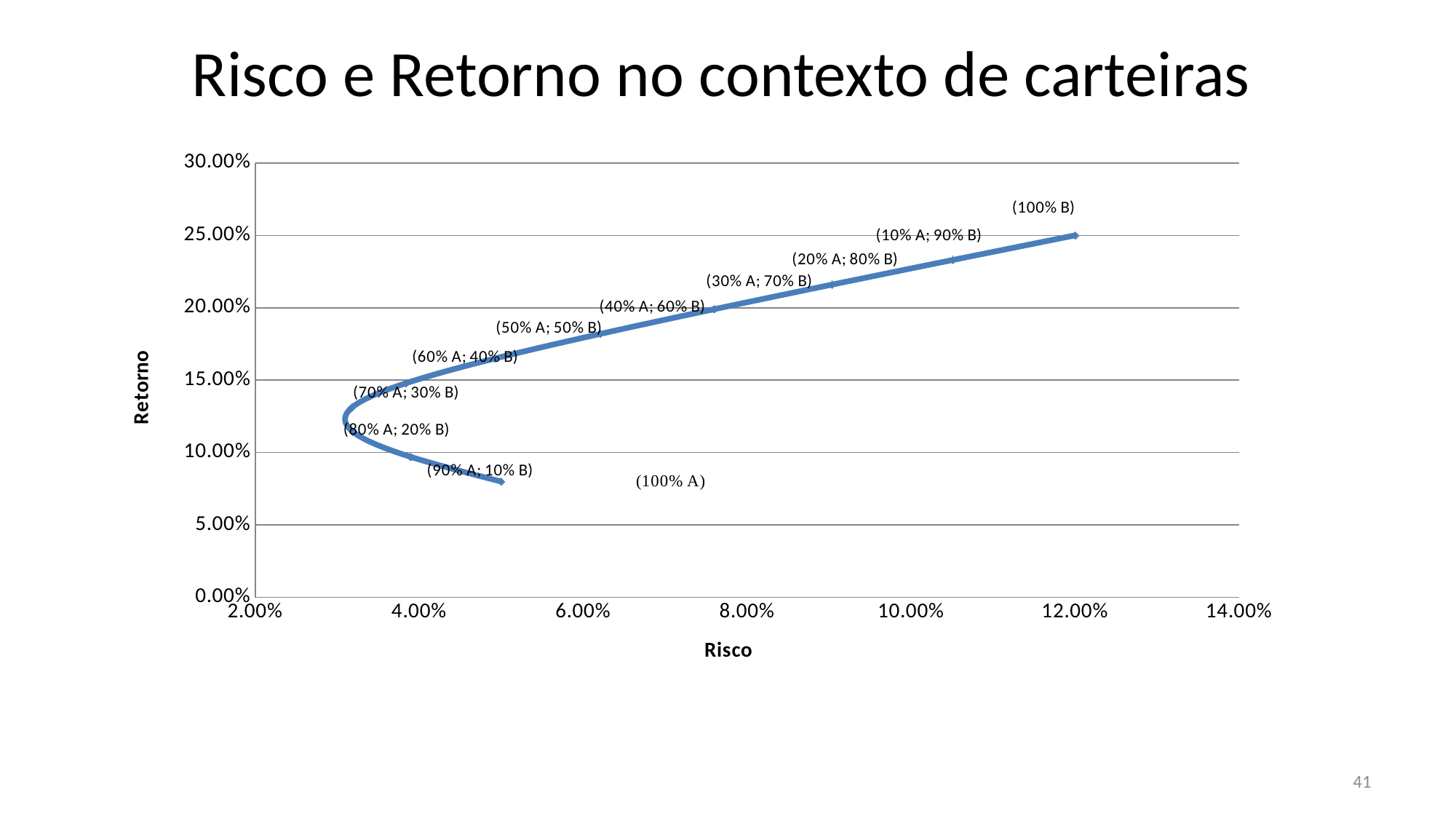
Which labeled portfolio has the highest risk (Risco)? (100% B) Which labeled portfolio has the lowest return (Retorno)? (100% A) What are the titles of the x axis and the y axis of the chart? Risco (x axis) and Retorno (y axis) Which portfolio has the higher return: (30% A; 70% B) or (60% A; 40% B)? (30% A; 70% B) Is the return for the (100% A) portfolio greater or less than 10.00%? less Which labeled portfolio has the highest return (Retorno)? (100% B) What kind of chart is shown on the slide? Line chart (scatter with smooth line) How many labeled portfolio points are plotted on the chart? 11 Is the risk for the (80% A; 20% B) portfolio greater or less than 4.00%? less Moving from the (80% A; 20% B) portfolio toward the (100% B) portfolio, does the return rise or fall as risk increases? rises Is the return for the (50% A; 50% B) portfolio greater or less than 15.00%? greater